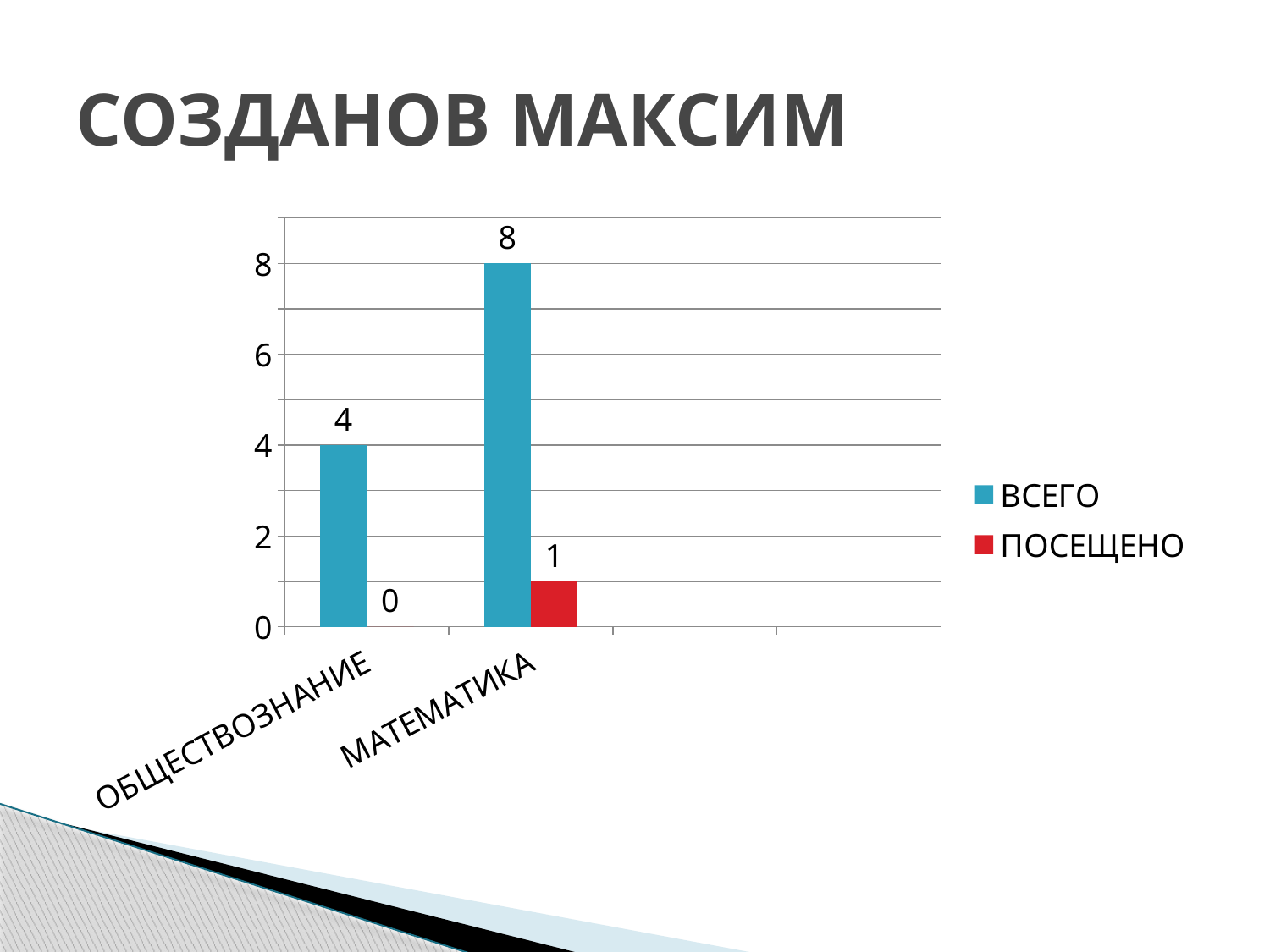
What is the ПОСЕЩЕНО value for МАТЕМАТИКА? 1 What is the ВСЕГО value for МАТЕМАТИКА? 8 What kind of chart is shown on the slide? Bar chart How many categories are shown on the x axis? 2 How many series does the legend list? 2 Which category has the lowest ПОСЕЩЕНО value? ОБЩЕСТВОЗНАНИЕ What is the ВСЕГО value for ОБЩЕСТВОЗНАНИЕ? 4 Which is larger for МАТЕМАТИКА: ВСЕГО or ПОСЕЩЕНО? ВСЕГО What is the difference between the ВСЕГО values for МАТЕМАТИКА and ОБЩЕСТВОЗНАНИЕ? 4 Which category has the highest ВСЕГО value? МАТЕМАТИКА What is the ПОСЕЩЕНО value for ОБЩЕСТВОЗНАНИЕ? 0 For МАТЕМАТИКА, what is the difference between ВСЕГО and ПОСЕЩЕНО? 7